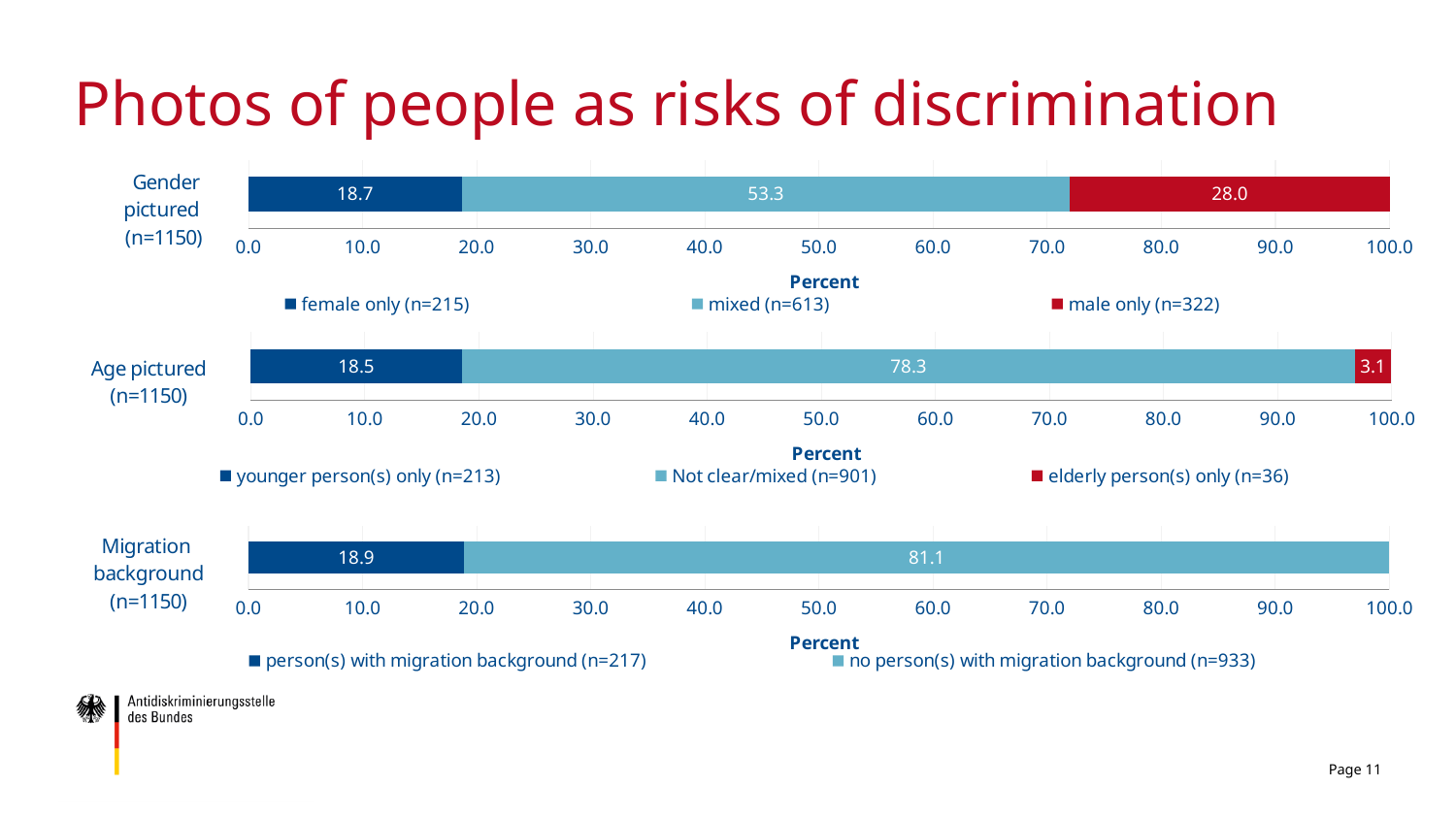
In the 'Gender pictured' chart, which series has the smallest value? female only (n=215) In the 'Gender pictured' chart, what is the value for 'male only (n=322)'? 28.0 In the 'Age pictured' chart, which series has the largest value? Not clear/mixed (n=901) What type of chart is the 'Gender pictured' chart? Stacked bar chart Which is larger: the 'female only' value in the 'Gender pictured' chart or the 'younger person(s) only' value in the 'Age pictured' chart? female only In the 'Gender pictured' chart, what is the difference between the 'mixed' value and the 'male only' value? 25.3 In the 'Age pictured' chart, what is the value for 'elderly person(s) only (n=36)'? 3.1 How many series does the legend of the 'Age pictured' chart list? 3 In the 'Migration background' chart, what is the difference between the two series values? 62.2 How many series does the legend of the 'Migration background' chart list? 2 In the 'Migration background' chart, what is the value for 'no person(s) with migration background (n=933)'? 81.1 In the 'Gender pictured' chart, what is the value for 'mixed (n=613)'? 53.3